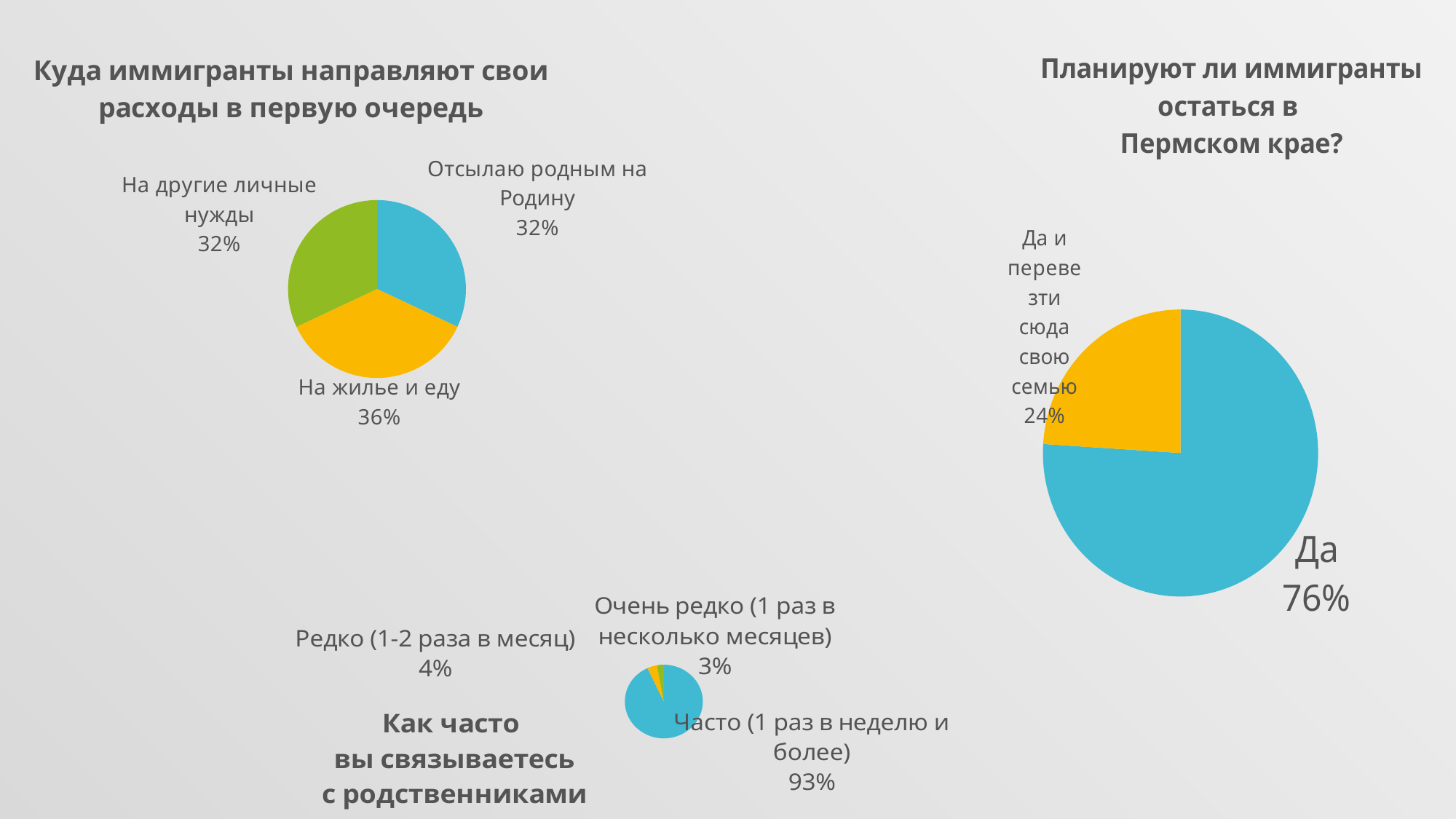
In the chart 'Как часто вы связываетесь с родственниками', which category has the smallest share? Очень редко (1 раз в несколько месяцев) In the chart 'Планируют ли иммигранты остаться в Пермском крае?', what share answered 'Да'? 76% In the chart 'Куда иммигранты направляют свои расходы в первую очередь', how many slices does the pie have? 3 In the chart 'Планируют ли иммигранты остаться в Пермском крае?', what share answered 'Да и перевезти сюда свою семью'? 24% In the chart 'Как часто вы связываетесь с родственниками', what share is 'Часто (1 раз в неделю и более)'? 93% In the chart 'Планируют ли иммигранты остаться в Пермском крае?', which answer has the smaller share? Да и перевезти сюда свою семью In the chart 'Куда иммигранты направляют свои расходы в первую очередь', what share goes to 'На жилье и еду'? 36% What kind of chart is 'Планируют ли иммигранты остаться в Пермском крае?'? pie chart How many pie charts are shown on the slide? 3 In the chart 'Как часто вы связываетесь с родственниками', which is larger: 'Редко (1-2 раза в месяц)' or 'Очень редко (1 раз в несколько месяцев)'? Редко (1-2 раза в месяц) In the chart 'Куда иммигранты направляют свои расходы в первую очередь', what is the difference between 'На жилье и еду' and 'Отсылаю родным на Родину'? 4% In the chart 'Куда иммигранты направляют свои расходы в первую очередь', which category has the largest share? На жилье и еду